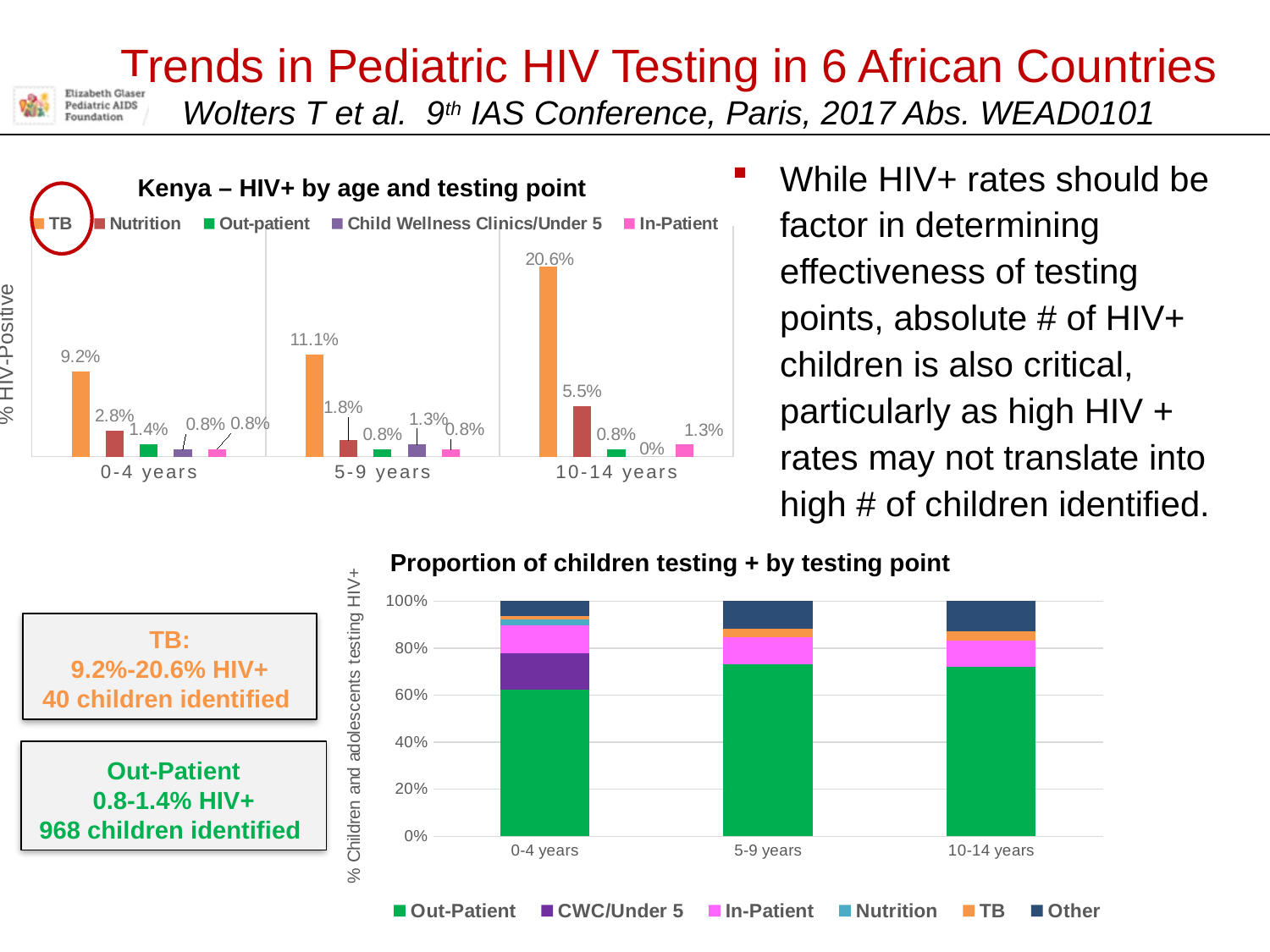
What kind of chart is 'Proportion of children testing + by testing point'? Stacked bar chart In the 'Kenya – HIV+ by age and testing point' chart, what is the difference between the TB values for 10-14 years and 0-4 years? 11.4% In the 'Kenya – HIV+ by age and testing point' chart, which testing point has the highest HIV+ rate for 5-9 years? TB How many series does the legend of the 'Proportion of children testing + by testing point' chart list? 6 In the 'Kenya – HIV+ by age and testing point' chart, what is the TB value for 10-14 years? 20.6% In the 'Kenya – HIV+ by age and testing point' chart, which is larger: Nutrition for 10-14 years or Nutrition for 5-9 years? Nutrition for 10-14 years In the 'Proportion of children testing + by testing point' chart, is the Out-Patient value for 5-9 years greater or less than 60%? greater In the 'Kenya – HIV+ by age and testing point' chart, how do the TB values change from 0-4 years to 10-14 years? They rise In the 'Kenya – HIV+ by age and testing point' chart, what is the Child Wellness Clinics/Under 5 value for 10-14 years? 0% How many age groups are shown on the x axis of the 'Proportion of children testing + by testing point' chart? 3 In the 'Kenya – HIV+ by age and testing point' chart, what is the Nutrition value for 0-4 years? 2.8% How many series does the legend of the 'Kenya – HIV+ by age and testing point' chart list? 5